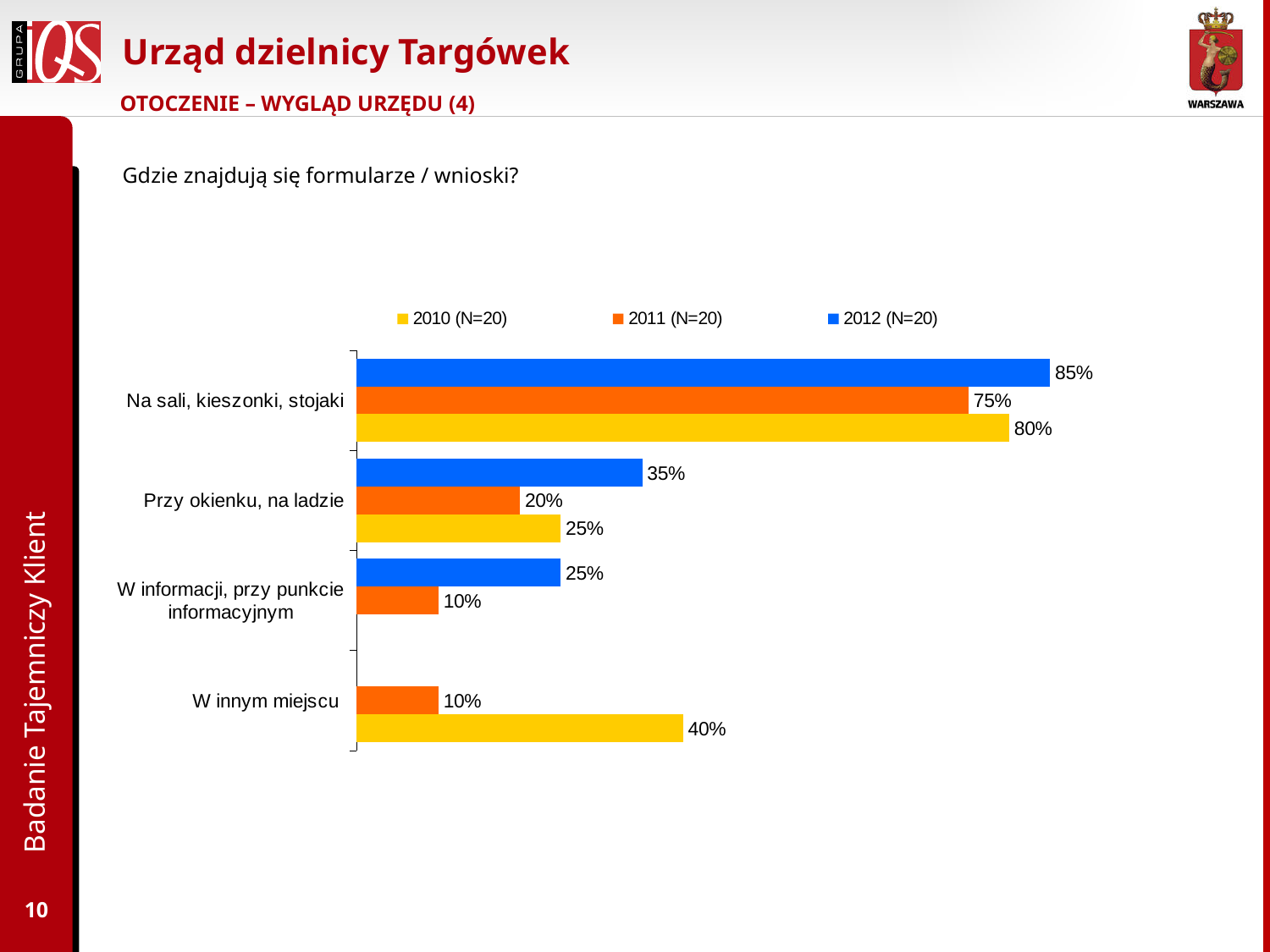
Which category has the lowest value in the 2011 (N=20) series? W informacji, przy punkcie informacyjnym and W innym miejscu (both 10%) How many categories are shown on the chart? 4 What kind of chart is shown on the slide? bar chart What is the value for 'W informacji, przy punkcie informacyjnym' in the 2012 (N=20) series? 25% What is the value for 'W innym miejscu' in the 2010 (N=20) series? 40% Which category has the highest value in the 2012 (N=20) series? Na sali, kieszonki, stojaki What is the value for 'Na sali, kieszonki, stojaki' in the 2012 (N=20) series? 85% How many series does the legend list? 3 What is the difference between the 2012 (N=20) and 2011 (N=20) values for 'Na sali, kieszonki, stojaki'? 10% Which is larger for 'Przy okienku, na ladzie': the 2010 (N=20) value or the 2012 (N=20) value? 2012 (N=20) What question is the chart answering, according to the text above it? Gdzie znajdują się formularze / wnioski? What is the value for 'Przy okienku, na ladzie' in the 2011 (N=20) series? 20%